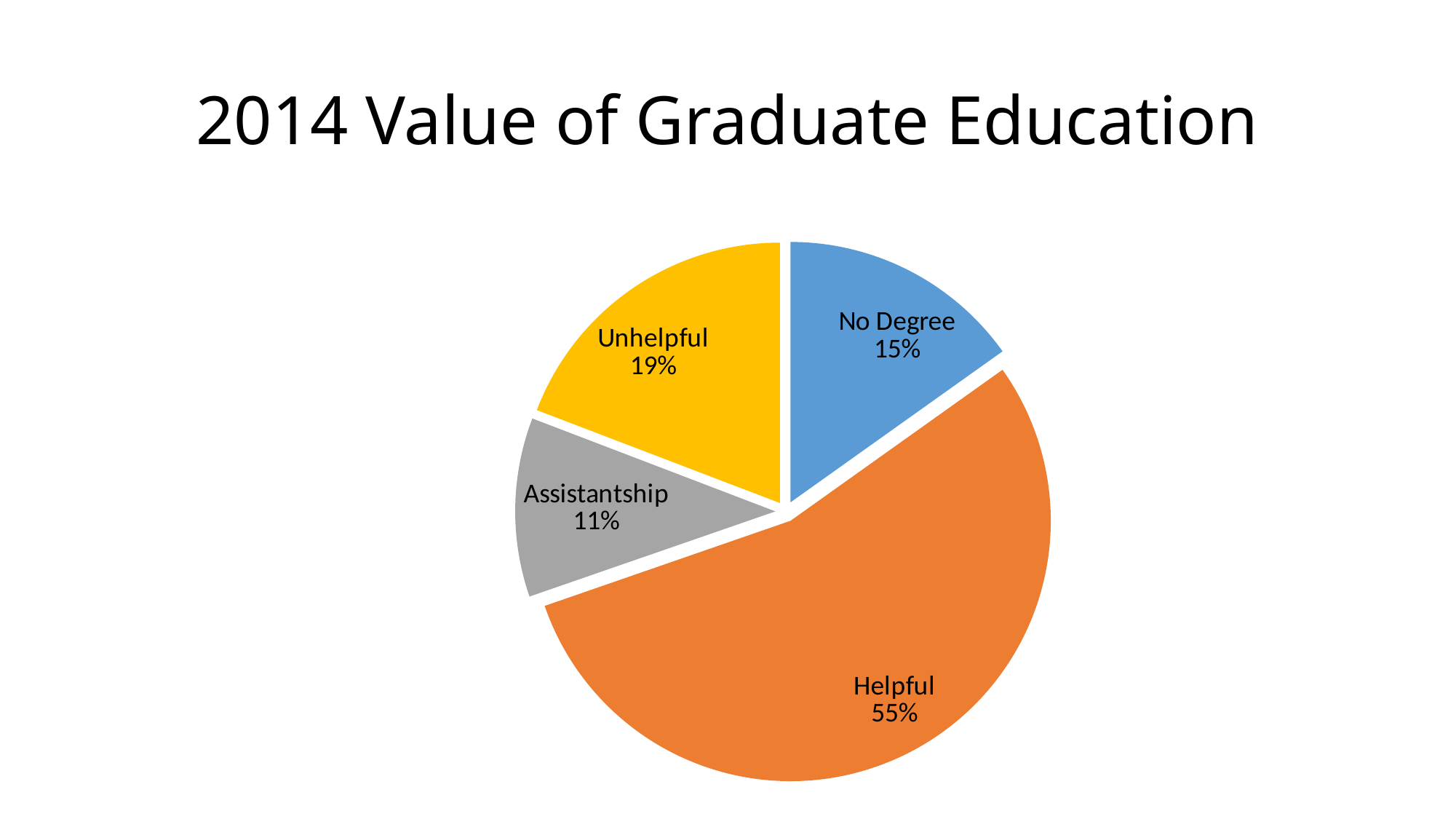
What type of chart is shown on the slide? pie chart Which is larger, the share for No Degree or the share for Assistantship? No Degree What is the value shown for Assistantship? 11% What share of the pie does the Helpful slice represent? 55% Which category has the largest slice of the pie? Helpful What is the difference in percentage points between Helpful and Unhelpful? 36 What is the value shown for Unhelpful? 19% What is the difference in percentage points between Unhelpful and No Degree? 4 Which category has the smallest slice of the pie? Assistantship What is the value shown for No Degree? 15% How many slices does the pie chart have? 4 What is the title of the slide? 2014 Value of Graduate Education